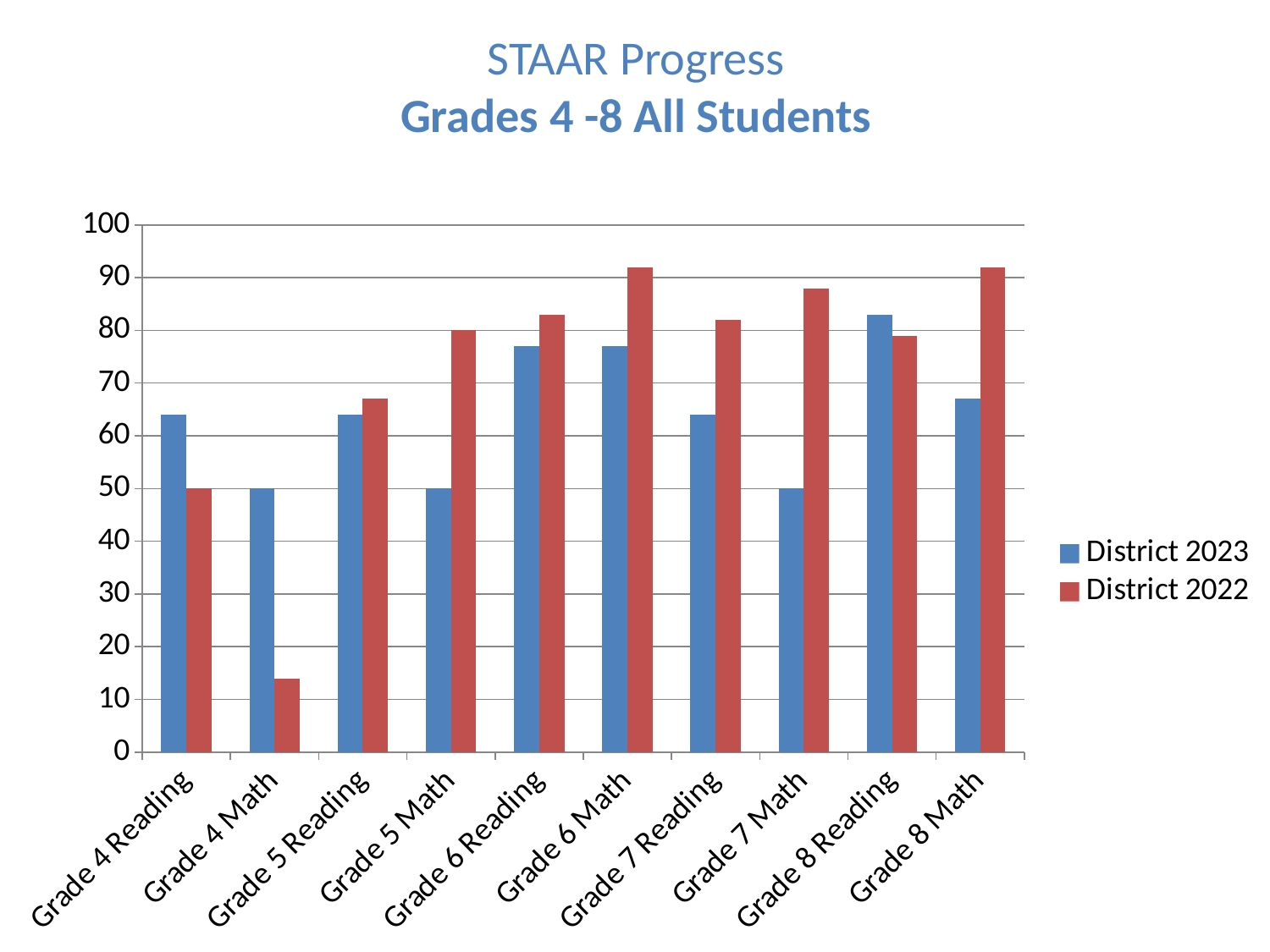
What is the value for District 2022 in Grade 5 Math? 80 Is the value for District 2023 in Grade 8 Reading greater or less than 80? greater In Grade 7 Math, which is larger, District 2023 or District 2022? District 2022 Which series is shown in red? District 2022 Is the value for District 2022 in Grade 6 Math greater or less than 90? greater Which category has the highest District 2023 value? Grade 8 Reading How many series does the legend list? 2 What kind of chart is shown on the slide? bar chart Which category has the lowest District 2022 value? Grade 4 Math Is the value for District 2022 in Grade 4 Math greater or less than 20? less What is the value for District 2023 in Grade 4 Math? 50 How many categories are shown on the x axis? 10